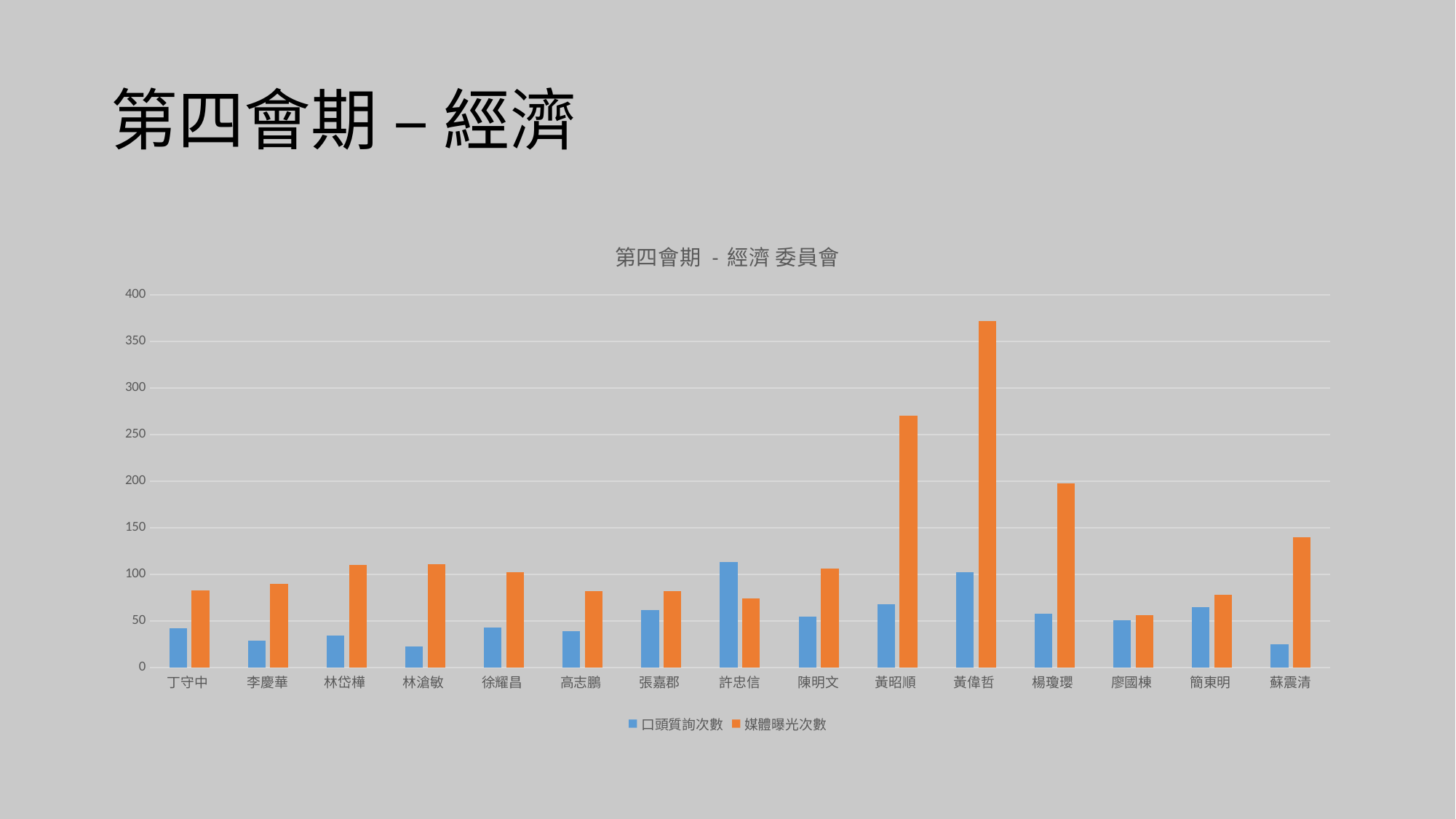
Is the 口頭質詢次數 value for 丁守中 greater or less than 50? less Which legislator has the highest 媒體曝光次數? 黃偉哲 What is the title of the chart? 第四會期 - 經濟 委員會 For 許忠信, which is larger: 口頭質詢次數 or 媒體曝光次數? 口頭質詢次數 Which legislator has the highest 口頭質詢次數? 許忠信 Which legislator has the lowest 媒體曝光次數? 廖國棟 What kind of chart is shown on the slide? bar chart Is the 口頭質詢次數 value for 許忠信 greater or less than 100? greater Is the 媒體曝光次數 value for 黃昭順 greater or less than 250? greater How many series does the legend list? 2 How many legislators (categories) are shown on the x axis? 15